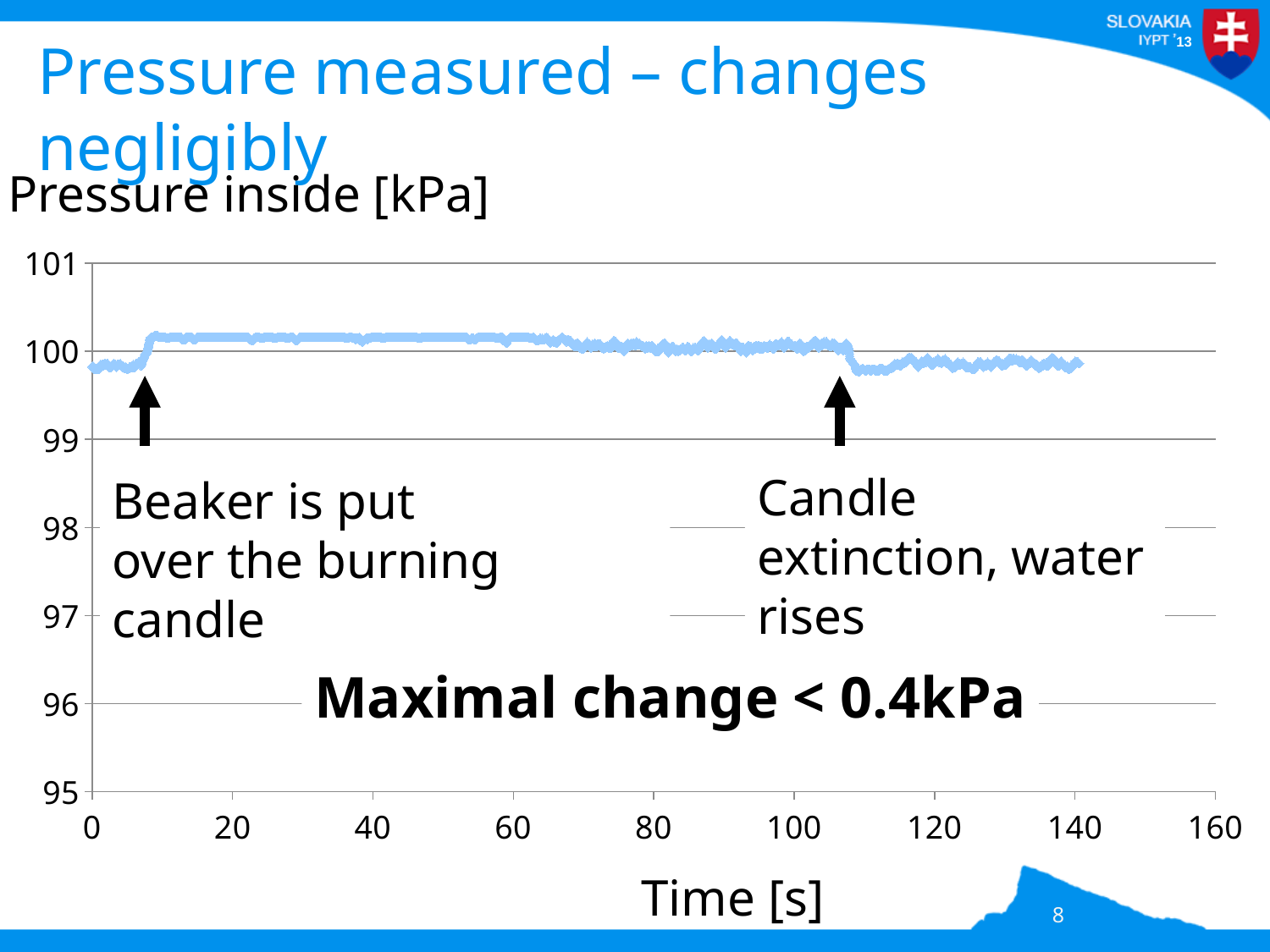
What is the label of the y axis of the chart? Pressure inside [kPa] Is the pressure value at time 40 s greater or less than 99 kPa? greater What kind of chart is shown on the slide? line chart Which is larger, the pressure at time 40 s or the pressure at time 120 s? time 40 s Does the pressure rise or fall when the beaker is put over the burning candle (around 8 s)? rise Does the pressure rise or fall at the moment the candle is extinguished (around 105 s)? fall Is the pressure value at time 120 s greater or less than 101 kPa? less What is the label of the x axis of the chart? Time [s] Is the pressure value at time 140 s greater or less than 98 kPa? greater